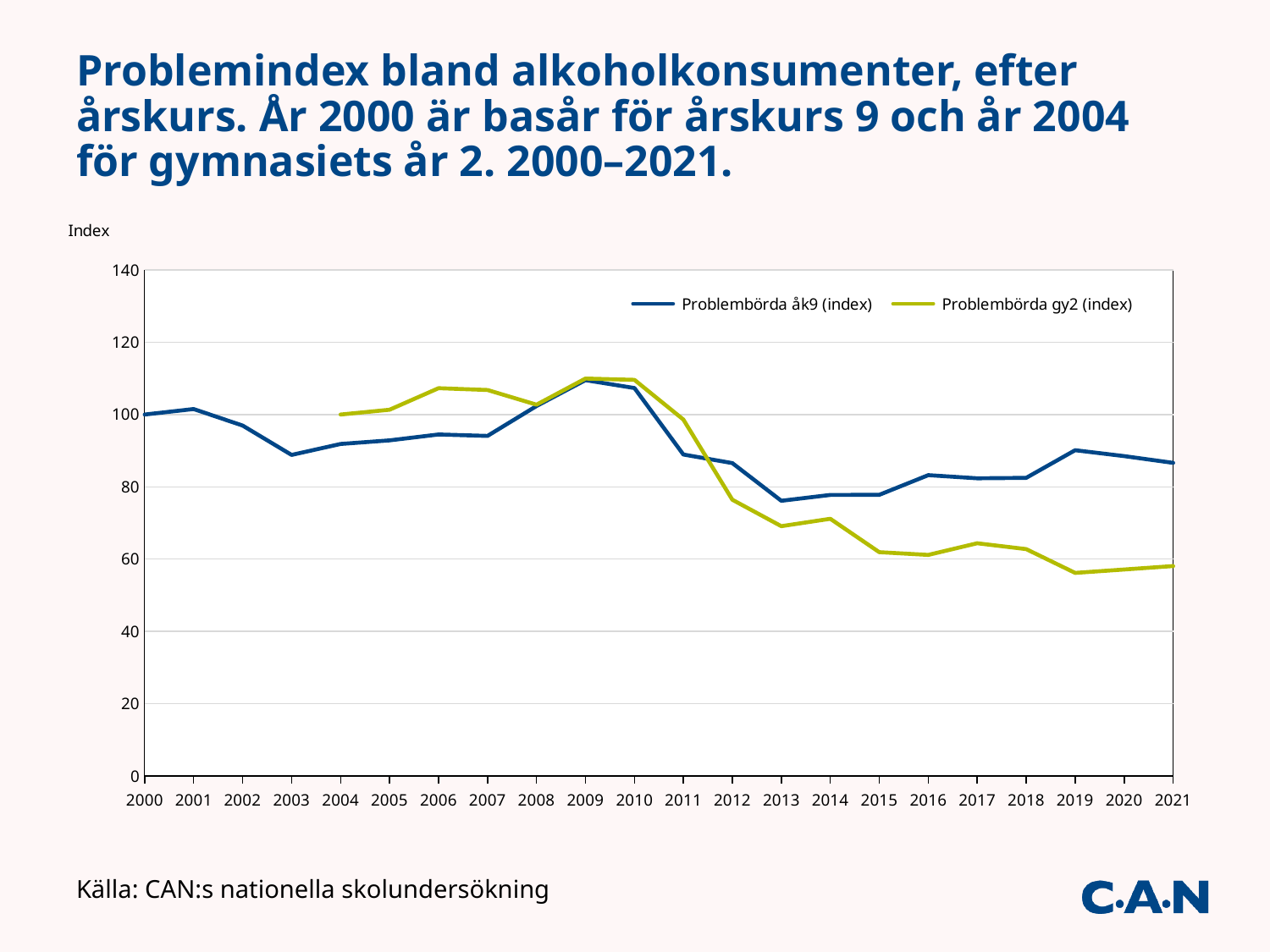
What is the value of Problembörda åk9 (index) in 2000? 100 Is the value for Problembörda gy2 (index) in 2006 greater or less than 100? greater What is the value of Problembörda gy2 (index) in 2004? 100 Is the value for Problembörda åk9 (index) in 2013 greater or less than 80? less What kind of chart is shown on the slide? line chart How many years are shown along the x axis? 22 What label is shown on the vertical axis? Index Is the value for Problembörda åk9 (index) in 2019 greater or less than 80? greater How many series does the legend list? 2 In 2015, which series has the larger value, Problembörda åk9 (index) or Problembörda gy2 (index)? Problembörda åk9 (index) Does the Problembörda gy2 (index) line rise or fall between 2010 and 2013? fall